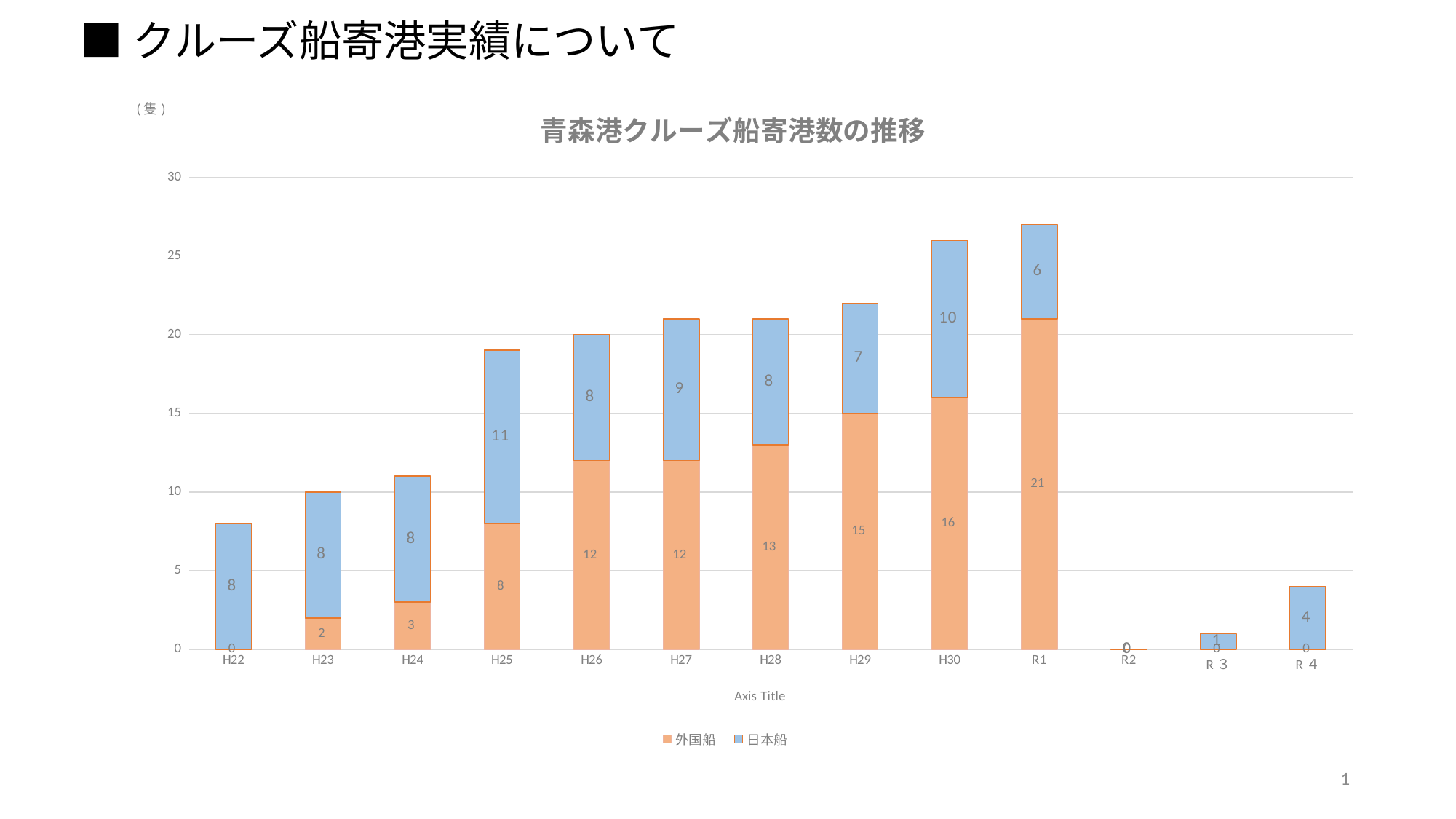
What is the difference between 外国船 and 日本船 in H30? 6 What is the value for 日本船 in H25? 11 What is the value for 外国船 in H29? 15 Which category has the highest value for 外国船? R1 What is the title of the chart? 青森港クルーズ船寄港数の推移 How many series does the legend list? 2 What is the total of the stacked bar for H30? 26 What kind of chart is shown on the slide? Stacked bar chart What is the value for 外国船 in R1? 21 Which is larger in H26, 外国船 or 日本船? 外国船 Which category has the highest value for 日本船? H25 How many categories are shown on the x axis? 13